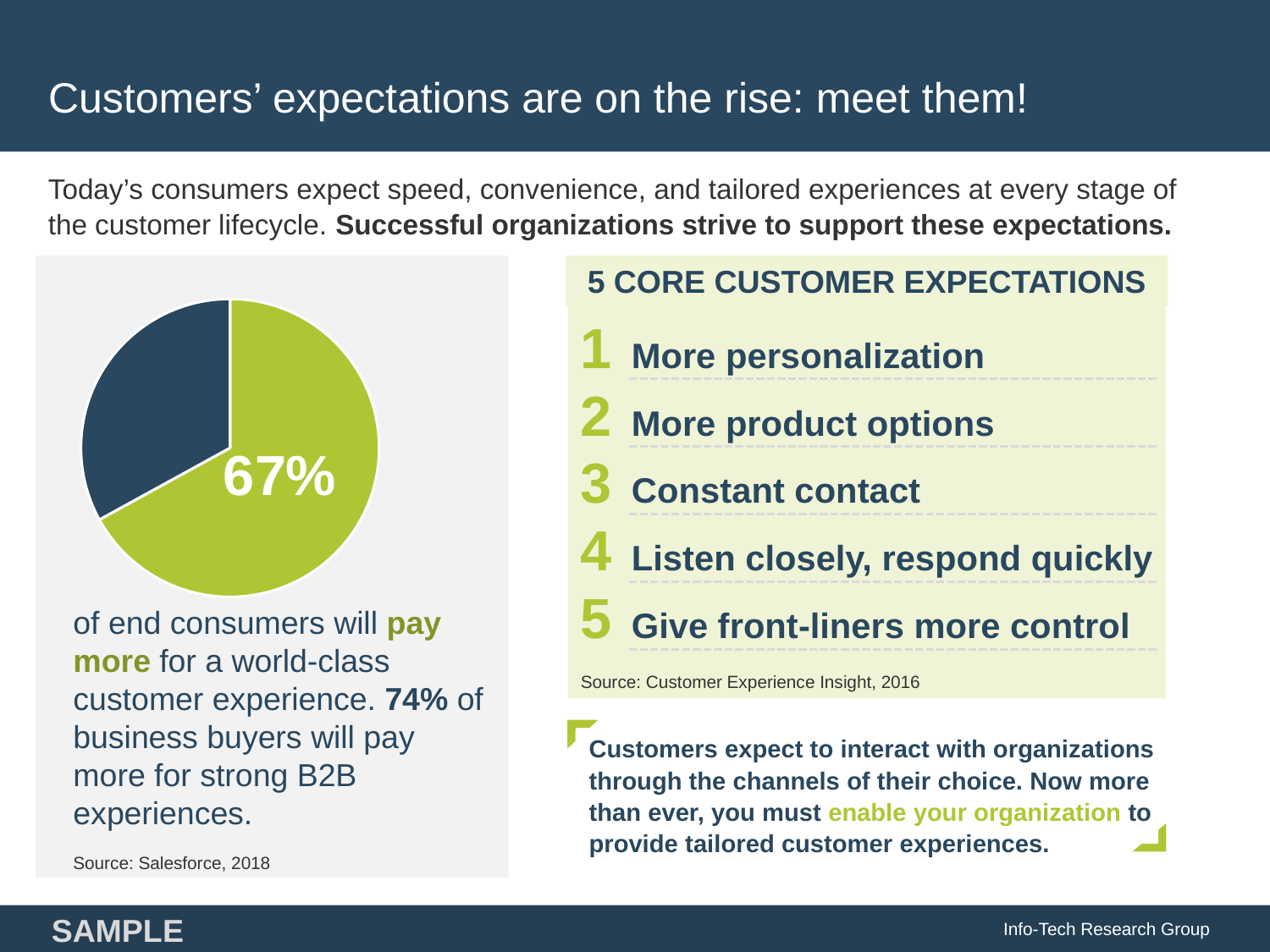
What kind of chart is shown on the left side of the slide? pie chart Is the green slice of the pie chart more or less than half of the pie? more What source is cited for the pie chart? Salesforce, 2018 How many slices does the pie chart have? 2 What percentage is printed on the large green slice of the pie chart? 67% Which slice of the pie chart is larger, the green slice or the dark blue slice? the green slice According to the text under the pie chart, what does the 67% slice represent? end consumers who will pay more for a world-class customer experience